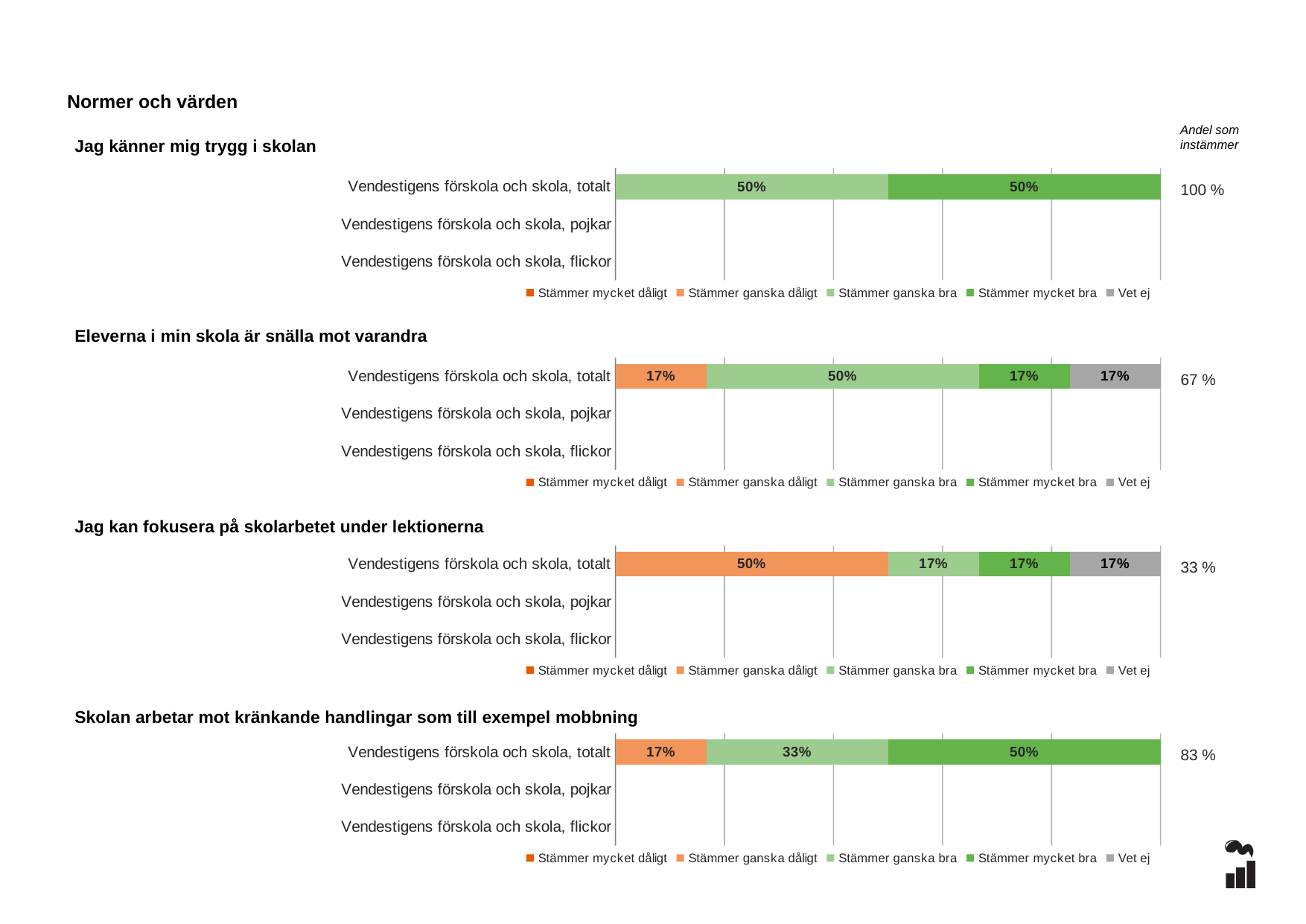
In the chart 'Eleverna i min skola är snälla mot varandra', which response category has the largest share for Vendestigens förskola och skola, totalt? Stämmer ganska bra How many series does the legend list in the chart 'Jag känner mig trygg i skolan'? 5 How many categories are shown on the vertical axis of the chart 'Eleverna i min skola är snälla mot varandra'? 3 In the chart 'Jag kan fokusera på skolarbetet under lektionerna', which response category has the largest share for Vendestigens förskola och skola, totalt? Stämmer ganska dåligt In the chart 'Skolan arbetar mot kränkande handlingar som till exempel mobbning', what is the value for 'Stämmer mycket bra' for Vendestigens förskola och skola, totalt? 50% In the chart 'Skolan arbetar mot kränkande handlingar som till exempel mobbning', what is the difference between the 'Stämmer mycket bra' and 'Stämmer ganska dåligt' values for Vendestigens förskola och skola, totalt? 33% What kind of chart is 'Jag känner mig trygg i skolan'? Stacked bar chart In the chart 'Jag kan fokusera på skolarbetet under lektionerna', which is larger for Vendestigens förskola och skola, totalt: 'Stämmer ganska dåligt' or 'Stämmer ganska bra'? Stämmer ganska dåligt In the chart 'Skolan arbetar mot kränkande handlingar som till exempel mobbning', what is the value for 'Stämmer ganska bra' for Vendestigens förskola och skola, totalt? 33% In the chart 'Jag känner mig trygg i skolan', what is the value for 'Stämmer ganska bra' for Vendestigens förskola och skola, totalt? 50% In the chart 'Eleverna i min skola är snälla mot varandra', what is the value for 'Stämmer ganska dåligt' for Vendestigens förskola och skola, totalt? 17% In the chart 'Jag kan fokusera på skolarbetet under lektionerna', what is the value for 'Stämmer ganska dåligt' for Vendestigens förskola och skola, totalt? 50%